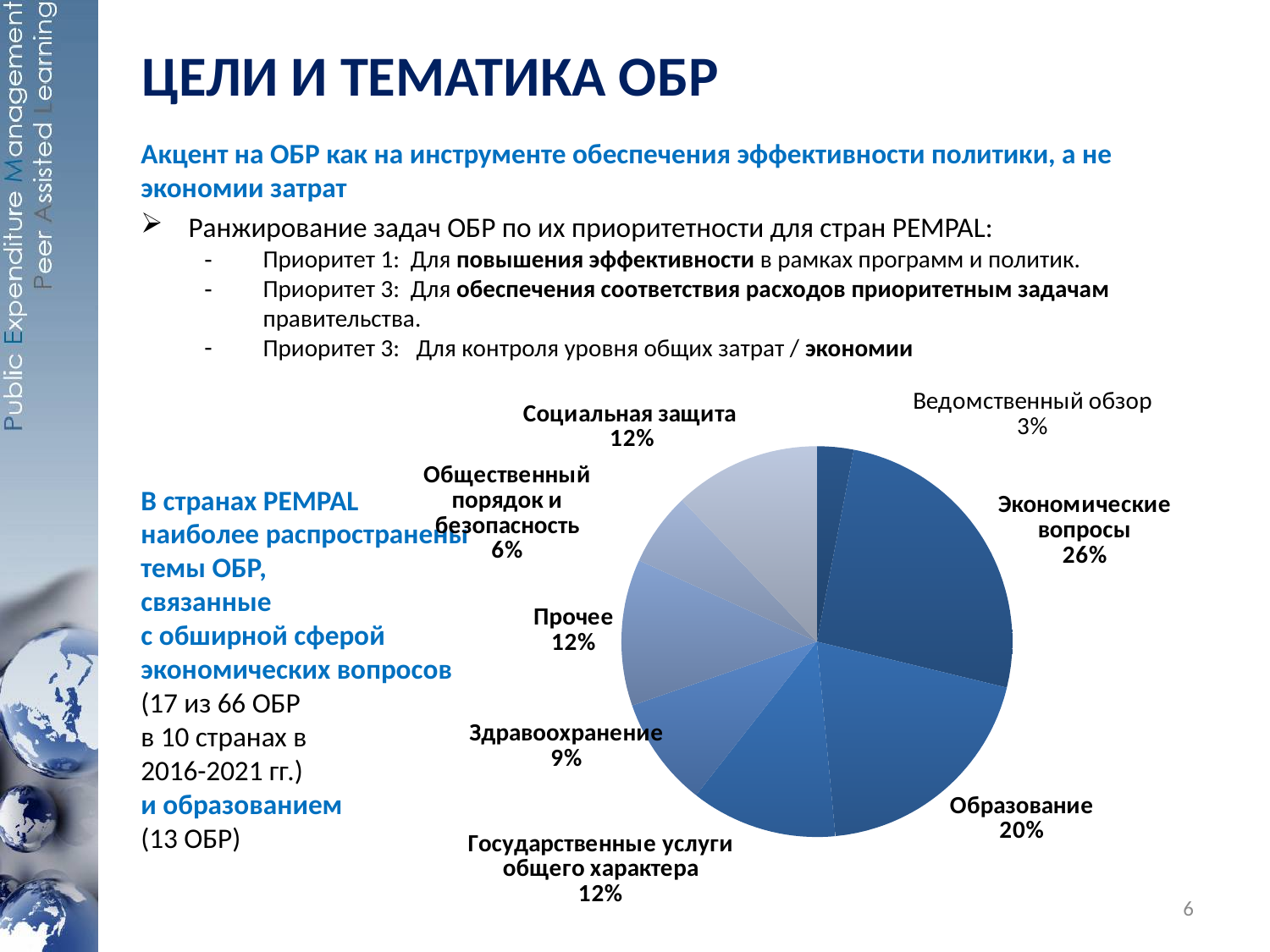
What share of the pie does "Ведомственный обзор" have? 3% What share of the pie does "Экономические вопросы" have? 26% Which category has the largest slice of the pie? Экономические вопросы Which is larger: the share for "Здравоохранение" or the share for "Прочее"? Прочее How many categories (slices) does the pie chart have? 8 What is the difference in percentage points between "Экономические вопросы" and "Образование"? 6 What share of the pie does "Образование" have? 20% Which category has the smallest slice of the pie? Ведомственный обзор What share of the pie does "Общественный порядок и безопасность" have? 6% What type of chart is shown on the slide? pie chart How many categories in the pie chart have a share of 12%? 3 What share of the pie does "Здравоохранение" have? 9%